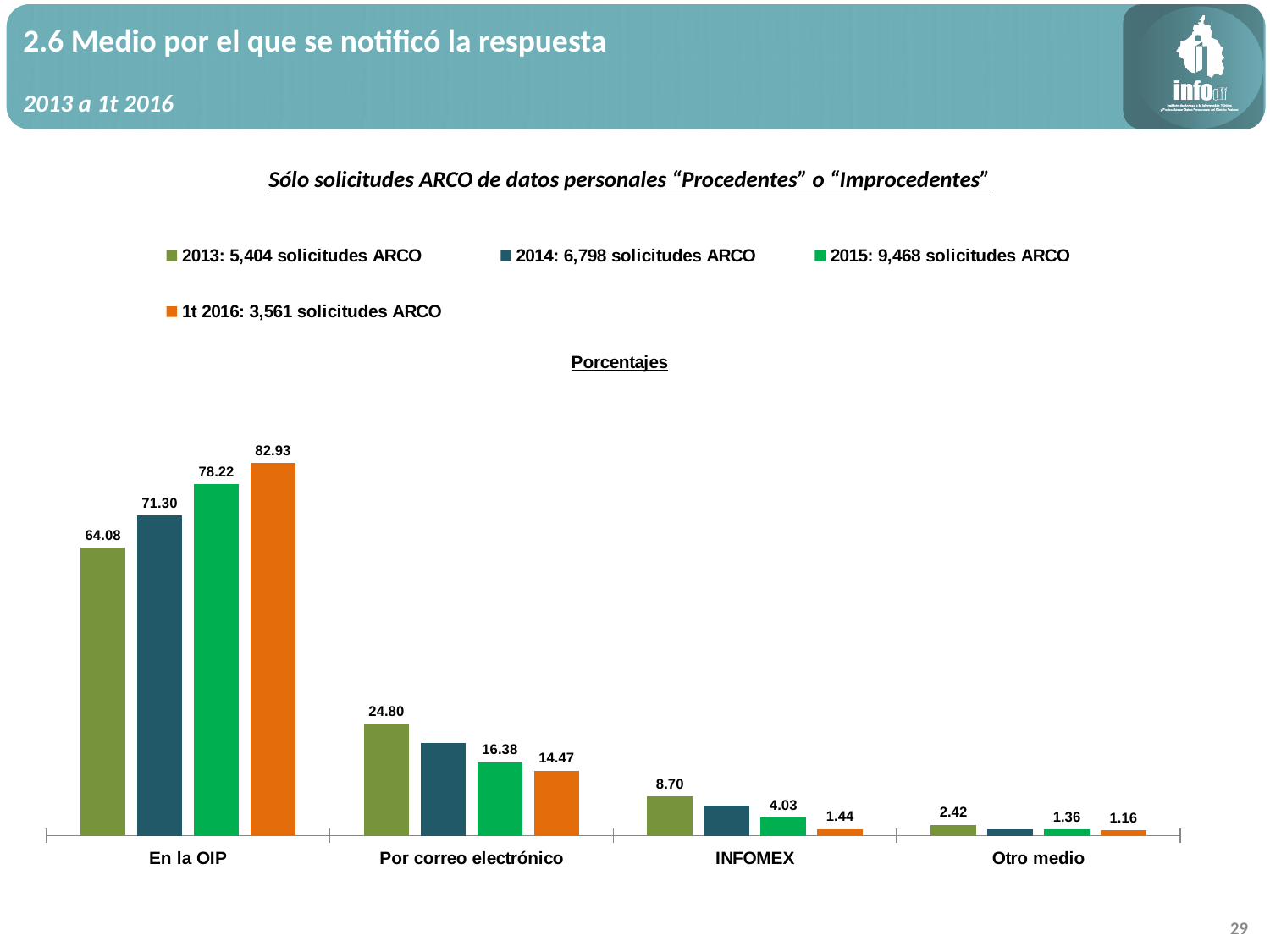
What is the value for 1t 2016 in the Por correo electrónico category? 14.47 In the En la OIP category, do the values rise or fall from 2013 to 1t 2016? Rise What is the difference between the 1t 2016 and 2013 values in the En la OIP category? 18.85 Which category has the highest value for the 2013 series? En la OIP How many categories are shown on the x axis? 4 In the Por correo electrónico category, which is larger: the 2013 value or the 2015 value? 2013 Which category has the lowest value for the 1t 2016 series? Otro medio What kind of chart is shown on the slide? Bar chart What is the value for 2015 in the Otro medio category? 1.36 What is the value for 2015 in the En la OIP category? 78.22 How many series does the legend list? 4 What is the value for 2013 in the INFOMEX category? 8.70